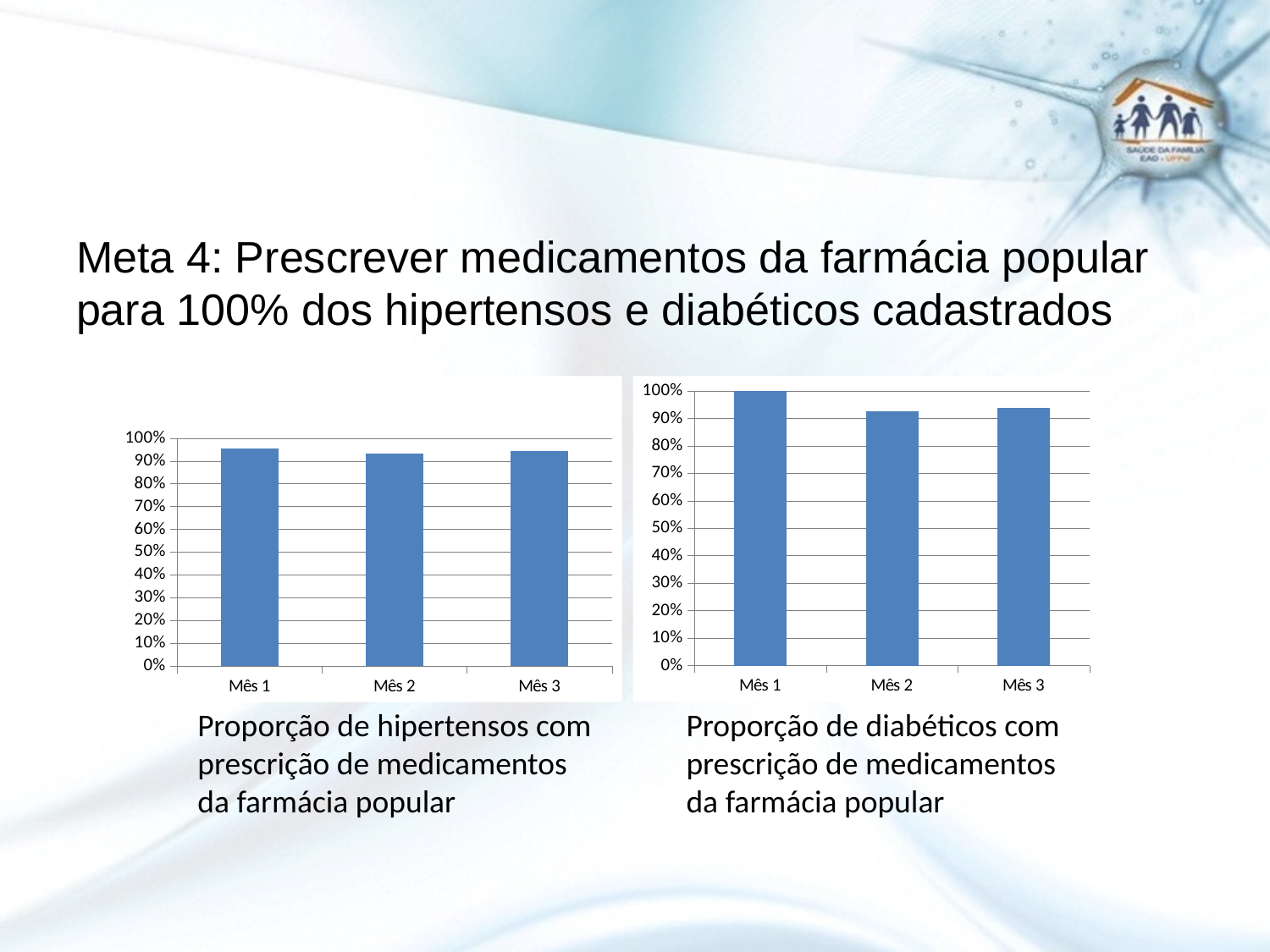
In the left chart (Proporção de hipertensos com prescrição de medicamentos da farmácia popular), how many months are shown on the x axis? 3 What is the caption under the right chart? Proporção de diabéticos com prescrição de medicamentos da farmácia popular What kind of chart is the left chart (Proporção de hipertensos com prescrição de medicamentos da farmácia popular)? bar chart In the left chart (Proporção de hipertensos com prescrição de medicamentos da farmácia popular), is the value for Mês 1 greater or less than 100%? less In the right chart (Proporção de diabéticos com prescrição de medicamentos da farmácia popular), what is the value for Mês 1? 100% In the right chart (Proporção de diabéticos com prescrição de medicamentos da farmácia popular), how many bars are plotted? 3 In the left chart (Proporção de hipertensos com prescrição de medicamentos da farmácia popular), is the value for Mês 2 greater or less than 90%? greater In the right chart (Proporção de diabéticos com prescrição de medicamentos da farmácia popular), is the value for Mês 3 greater or less than 80%? greater In the right chart (Proporção de diabéticos com prescrição de medicamentos da farmácia popular), which month has the highest value? Mês 1 What is the highest value shown on the y axis of the left chart (Proporção de hipertensos com prescrição de medicamentos da farmácia popular)? 100% In the right chart (Proporção de diabéticos com prescrição de medicamentos da farmácia popular), which is larger, the value for Mês 1 or the value for Mês 2? Mês 1